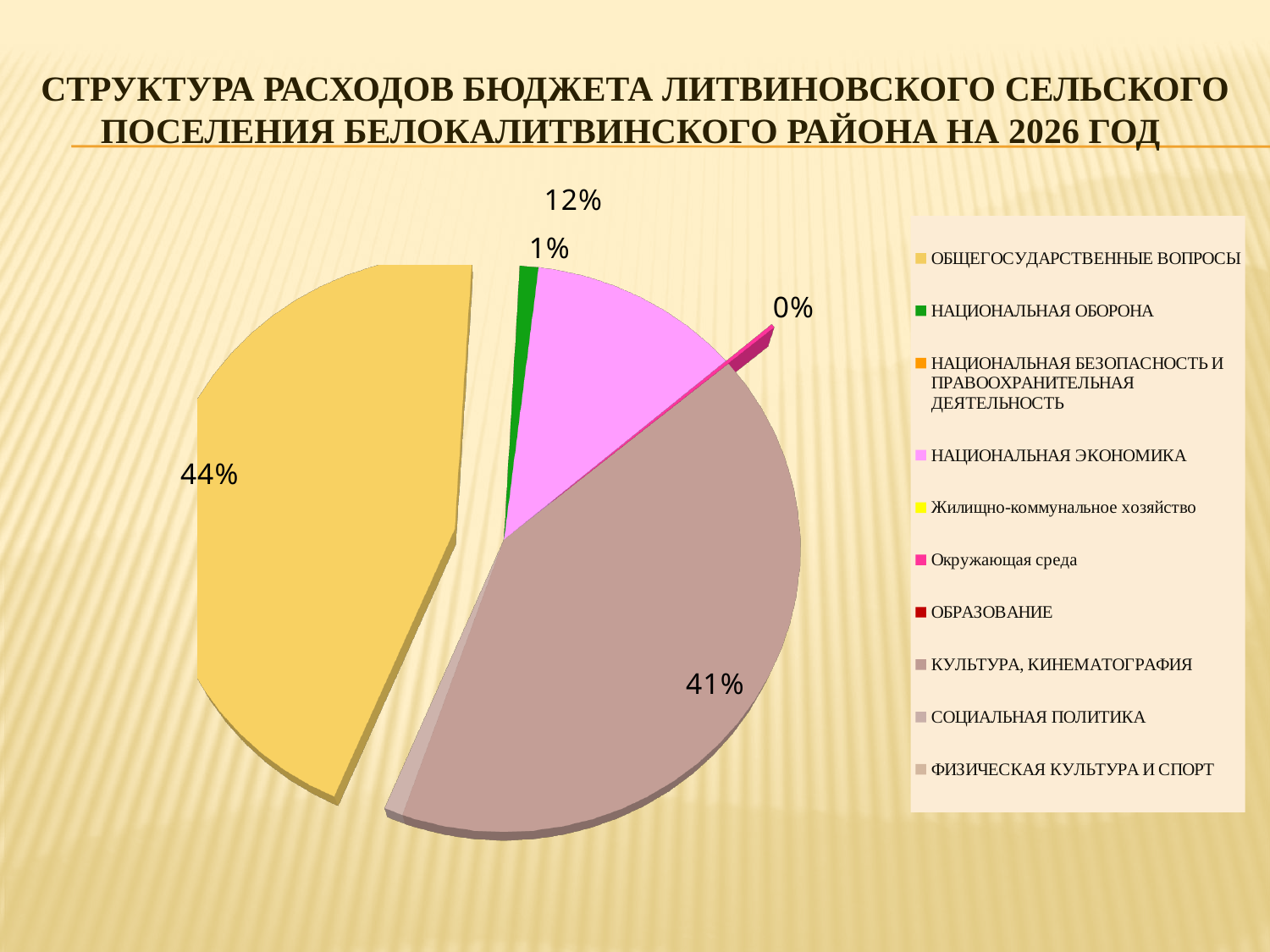
What share of the budget expenditure goes to КУЛЬТУРА, КИНЕМАТОГРАФИЯ? 41% What is the difference in percentage points between the share for КУЛЬТУРА, КИНЕМАТОГРАФИЯ and the share for НАЦИОНАЛЬНАЯ ОБОРОНА? 40 percentage points What share of the budget expenditure goes to ОБЩЕГОСУДАРСТВЕННЫЕ ВОПРОСЫ? 44% What share of the budget expenditure goes to НАЦИОНАЛЬНАЯ ОБОРОНА? 1% What colour is the slice for НАЦИОНАЛЬНАЯ ОБОРОНА? green Which category has the largest share of the budget expenditure? ОБЩЕГОСУДАРСТВЕННЫЕ ВОПРОСЫ Which is larger, the share for ОБЩЕГОСУДАРСТВЕННЫЕ ВОПРОСЫ or the share for КУЛЬТУРА, КИНЕМАТОГРАФИЯ? ОБЩЕГОСУДАРСТВЕННЫЕ ВОПРОСЫ What kind of chart is shown on the slide? pie chart What is the difference in percentage points between the share for ОБЩЕГОСУДАРСТВЕННЫЕ ВОПРОСЫ and the share for НАЦИОНАЛЬНАЯ ЭКОНОМИКА? 32 percentage points What share of the budget expenditure goes to НАЦИОНАЛЬНАЯ ЭКОНОМИКА? 12% What share is shown for Окружающая среда? 0% How many categories does the legend list? 10